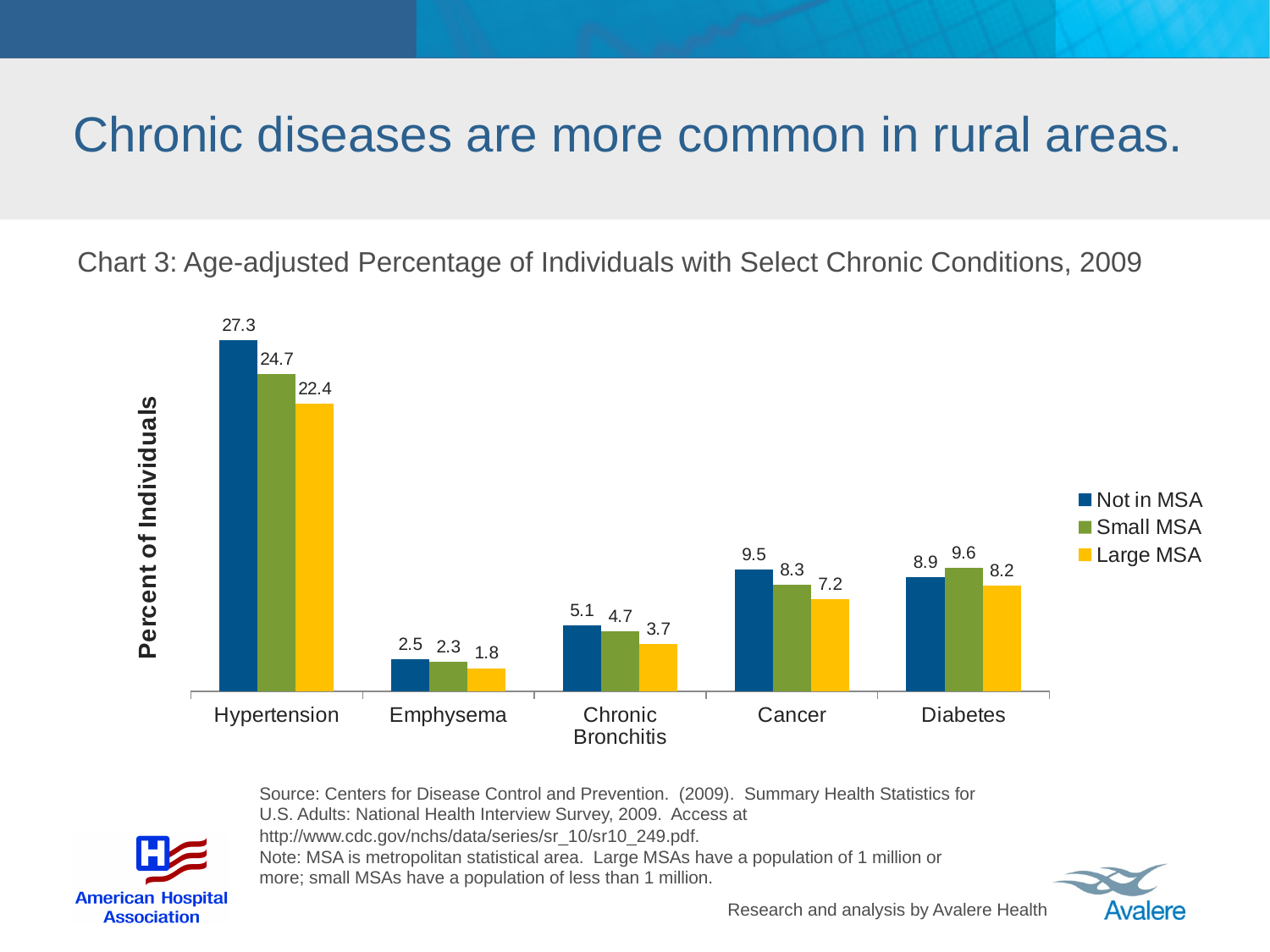
What is the value for Large MSA for Chronic Bronchitis? 3.7 What is the difference between the Not in MSA and Large MSA values for Hypertension? 4.9 What is the difference between the Not in MSA and Small MSA values for Cancer? 1.2 What is the value for Small MSA for Diabetes? 9.6 Which is larger for Diabetes: Not in MSA or Small MSA? Small MSA What is the y-axis label of the chart? Percent of Individuals What is the value for Not in MSA for Hypertension? 27.3 Which condition has the highest value for Not in MSA? Hypertension How many chronic conditions are shown on the x axis? 5 How many series does the legend list? 3 What kind of chart is shown? Bar chart Which condition has the lowest value for Large MSA? Emphysema